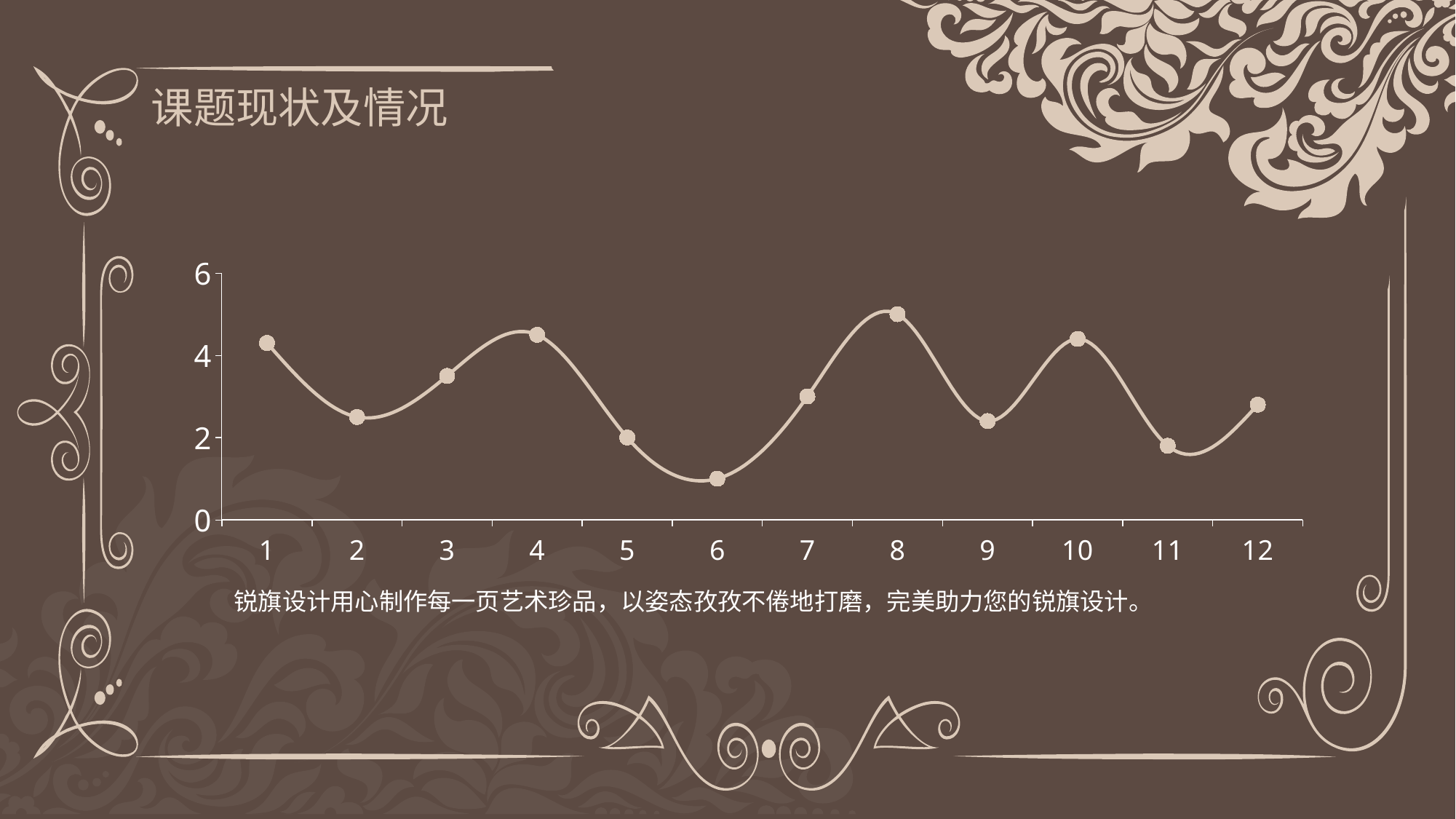
Is the value for category 8 greater or less than 4? greater How many data points are plotted on the line chart? 12 Which category has the lowest value on the line chart? 6 What is the title of the slide containing the chart? 课题现状及情况 Which category has the highest value on the line chart? 8 Which has the larger value, category 10 or category 9? 10 What kind of chart is shown on the slide? line chart Do the values rise or fall from category 4 to category 6? fall Is the value for category 6 greater or less than 2? less Which has the larger value, category 4 or category 5? 4 Is the value for category 1 greater or less than 4? greater